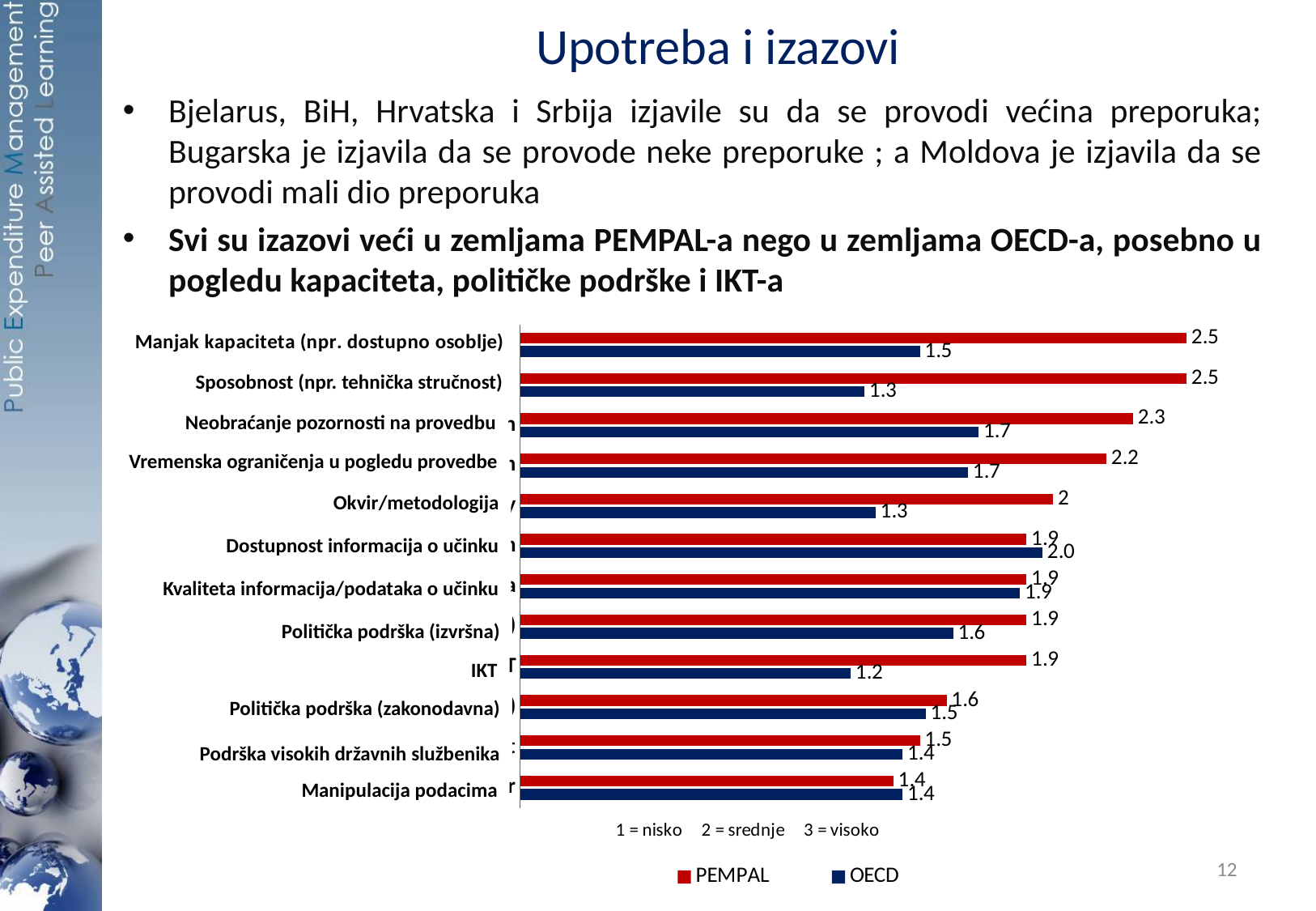
What is the OECD value for IKT? 1.2 How many series does the legend list? 2 Which category has the lowest PEMPAL value? Manipulacija podacima What is the OECD value for Sposobnost (npr. tehnička stručnost)? 1.3 What is the PEMPAL value for Manjak kapaciteta (npr. dostupno osoblje)? 2.5 What is the PEMPAL value for Okvir/metodologija? 2 Which category has the lowest OECD value? IKT What kind of chart is shown on the slide? Bar chart How many categories are shown in the chart? 12 What is the difference between the PEMPAL and OECD values for Manjak kapaciteta (npr. dostupno osoblje)? 1 For Dostupnost informacija o učinku, which series has the larger value, PEMPAL or OECD? OECD What is the difference between the PEMPAL and OECD values for IKT? 0.7